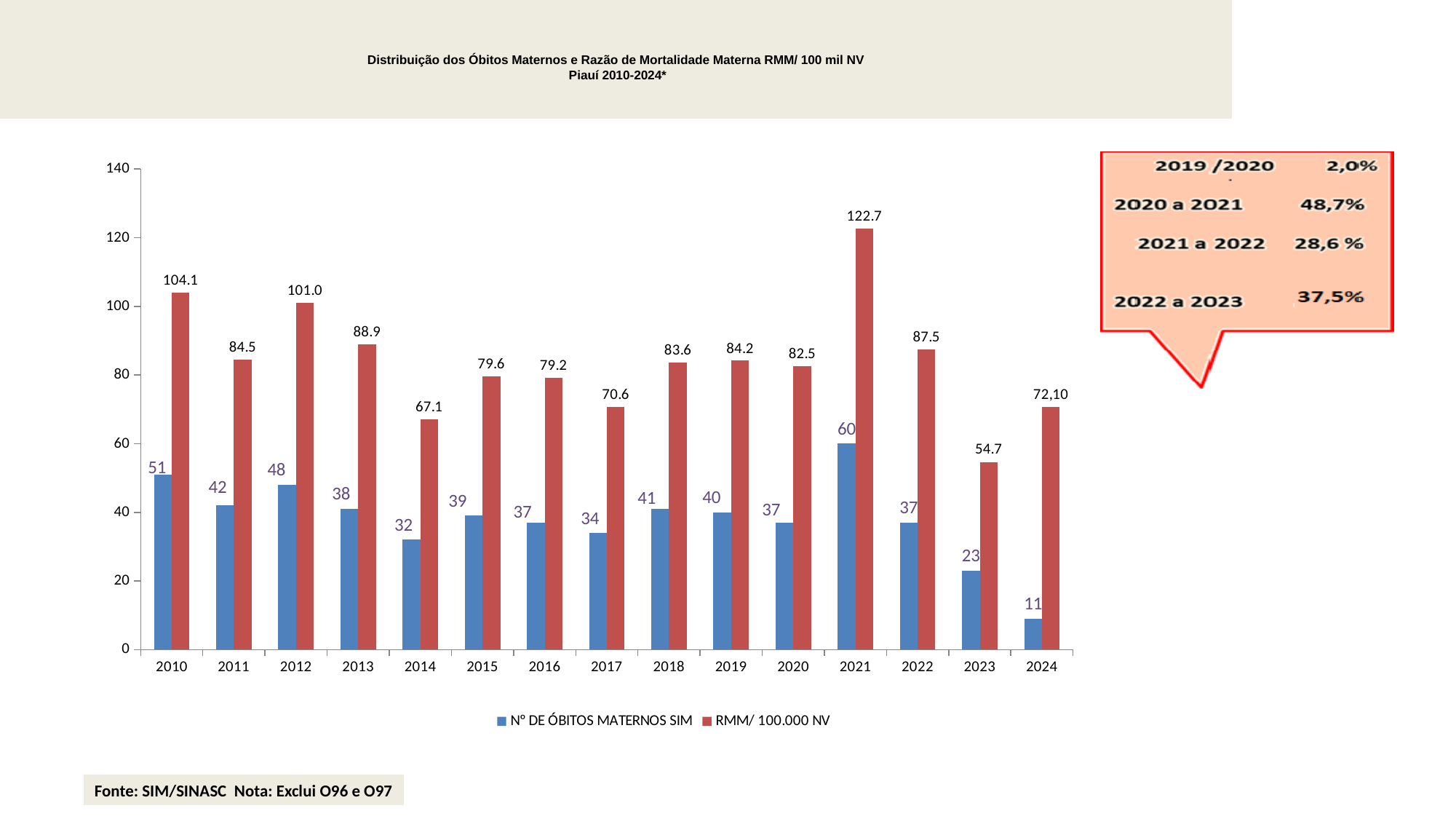
What is the RMM/ 100.000 NV value for 2024? 72,10 How many series does the legend list? 2 What is the difference between the Nº DE ÓBITOS MATERNOS SIM values for 2021 and 2020? 23 What is the difference between the RMM/ 100.000 NV values for 2010 and 2011? 19.6 Which year has the lowest RMM/ 100.000 NV value? 2023 What is the RMM/ 100.000 NV value for 2021? 122.7 How many years are shown on the x axis of the chart? 15 Which year has a larger RMM/ 100.000 NV value, 2012 or 2013? 2012 What is the Nº DE ÓBITOS MATERNOS SIM value for 2010? 51 Which year has the highest Nº DE ÓBITOS MATERNOS SIM value? 2021 Is the RMM/ 100.000 NV value for 2014 greater or less than 80? less Which year has the highest RMM/ 100.000 NV value? 2021